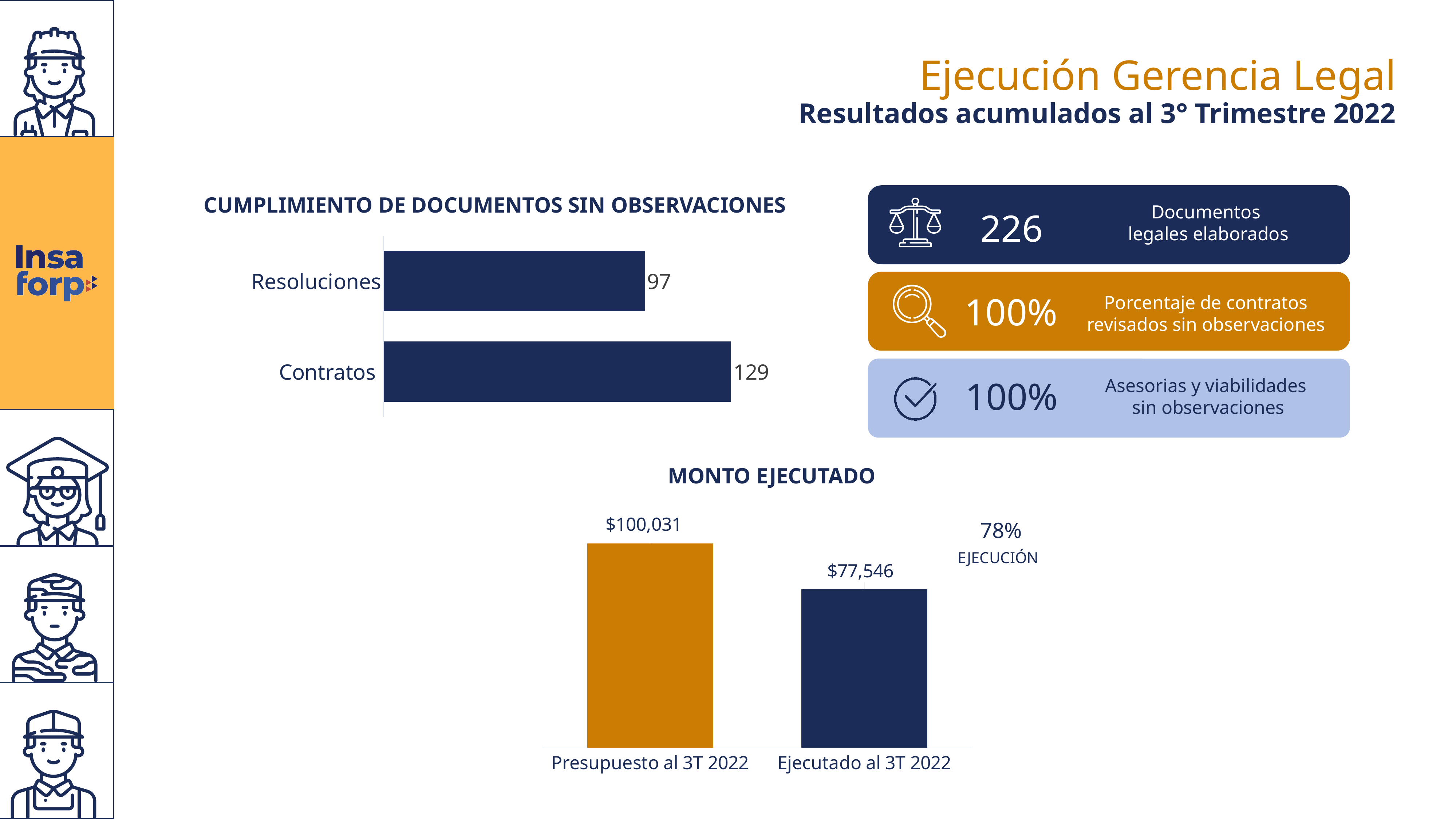
In the 'MONTO EJECUTADO' chart, what is the value for Ejecutado al 3T 2022? $77,546 What kind of chart is 'CUMPLIMIENTO DE DOCUMENTOS SIN OBSERVACIONES'? Bar chart In the 'MONTO EJECUTADO' chart, what is the value for Presupuesto al 3T 2022? $100,031 In the 'CUMPLIMIENTO DE DOCUMENTOS SIN OBSERVACIONES' chart, which category has the highest value? Contratos In the 'CUMPLIMIENTO DE DOCUMENTOS SIN OBSERVACIONES' chart, what is the difference between Contratos and Resoluciones? 32 In the 'MONTO EJECUTADO' chart, what colour is the Presupuesto al 3T 2022 bar? Orange In the 'MONTO EJECUTADO' chart, what is the difference between Presupuesto al 3T 2022 and Ejecutado al 3T 2022? $22,485 In the 'MONTO EJECUTADO' chart, which is larger: Presupuesto al 3T 2022 or Ejecutado al 3T 2022? Presupuesto al 3T 2022 In the 'MONTO EJECUTADO' chart, what execution percentage is shown next to the bars? 78% In the 'CUMPLIMIENTO DE DOCUMENTOS SIN OBSERVACIONES' chart, how many categories are shown? 2 In the 'CUMPLIMIENTO DE DOCUMENTOS SIN OBSERVACIONES' chart, what is the value for Contratos? 129 In the 'CUMPLIMIENTO DE DOCUMENTOS SIN OBSERVACIONES' chart, what is the value for Resoluciones? 97